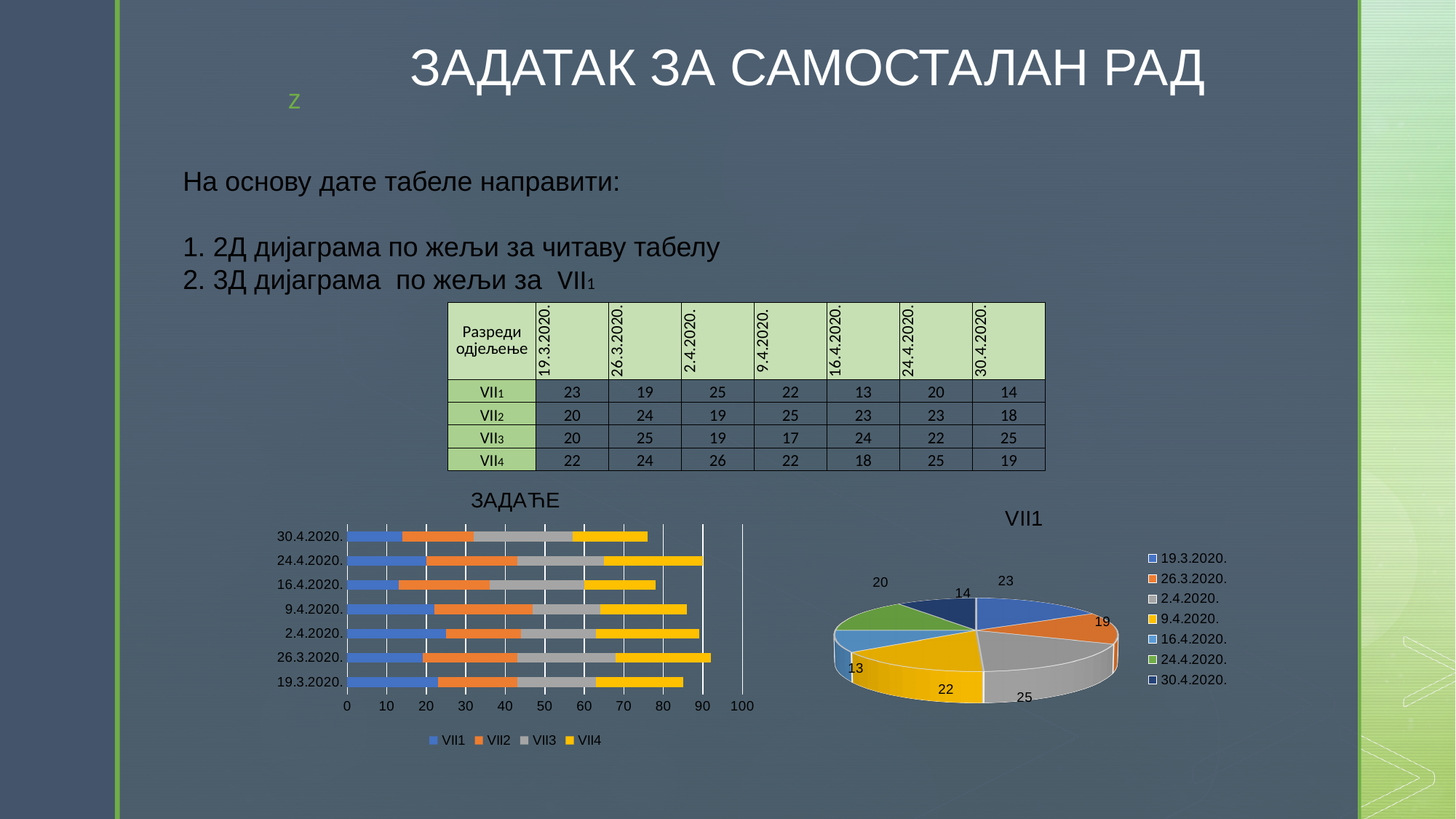
In the VII1 pie chart, which date has the largest slice? 2.4.2020. In the VII1 pie chart, which date has the smallest slice? 16.4.2020. In the VII1 pie chart, what is the value for 2.4.2020.? 25 In the ЗАДАЋЕ chart, is the total length of the bar for 19.3.2020. greater or less than 80? greater How many date categories are shown on the y axis of the ЗАДАЋЕ chart? 7 In the VII1 pie chart, what is the difference between the values for 2.4.2020. and 16.4.2020.? 12 In the VII1 pie chart, what is the value for 16.4.2020.? 13 In the VII1 pie chart, which is larger: the value for 9.4.2020. or the value for 24.4.2020.? 9.4.2020. What type of chart is the chart titled VII1? pie chart What type of chart is the chart titled ЗАДАЋЕ? bar chart How many series does the legend of the ЗАДАЋЕ chart list? 4 In the ЗАДАЋЕ chart, is the total length of the bar for 30.4.2020. greater or less than 80? less